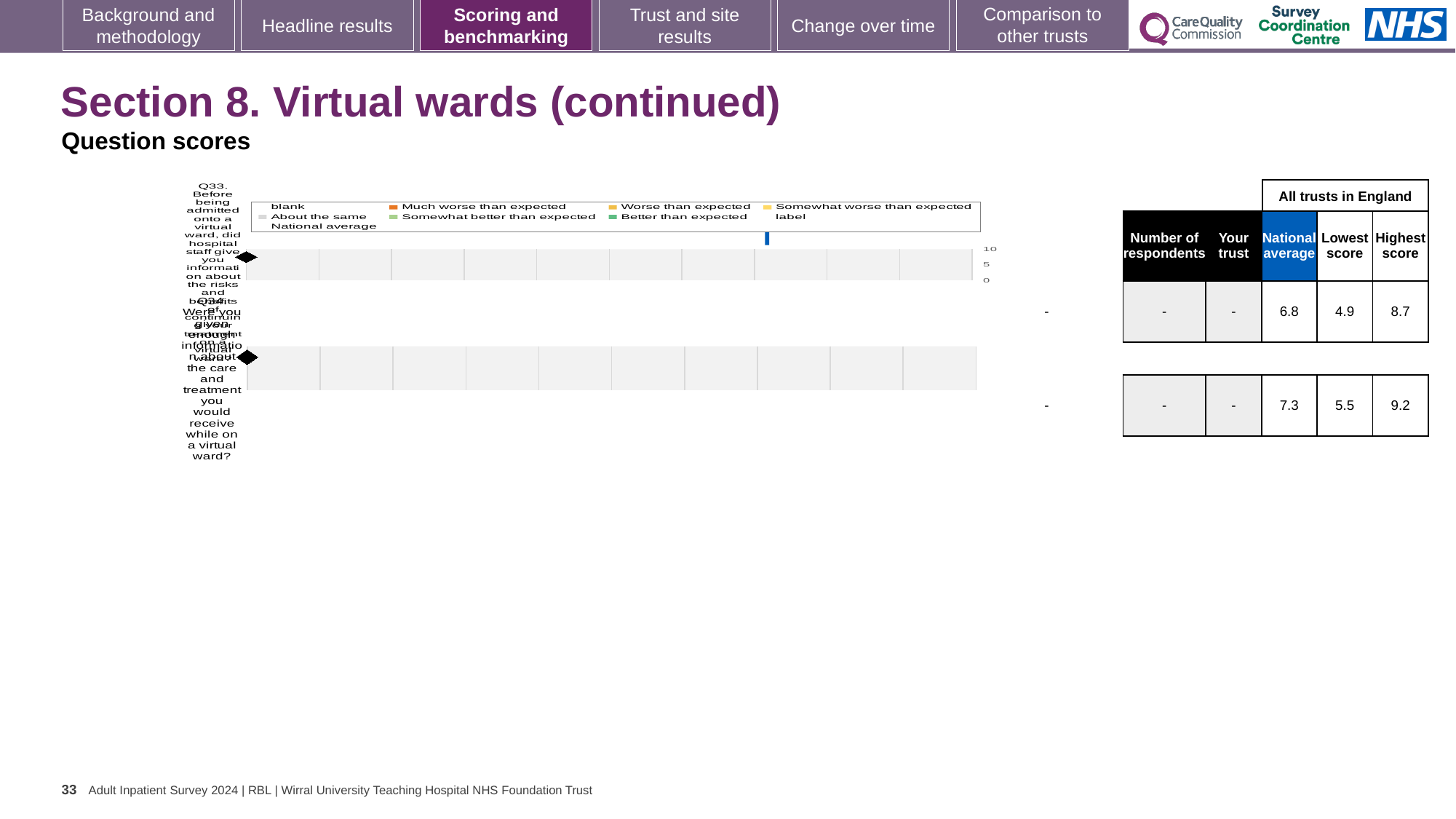
In the table beside the chart, what is the highest score for Q33? 8.7 How many questions (categories) are plotted on the chart? 2 Which question has the higher national average in the table, Q33 or Q34? Q34 What is the difference between the highest and lowest scores for Q33 in the table? 3.8 In the table beside the chart, what is the national average score for Q34? 7.3 In the table beside the chart, what is the lowest score for Q34? 5.5 Which two question numbers are plotted on the chart? Q33 and Q34 What is shown as the 'Your trust' score for Q33 in the table? - In the table beside the chart, what is the national average score for Q33? 6.8 What kind of chart is shown on the slide? bar chart In the table beside the chart, what is the highest score for Q34? 9.2 In the table beside the chart, what is the lowest score for Q33? 4.9